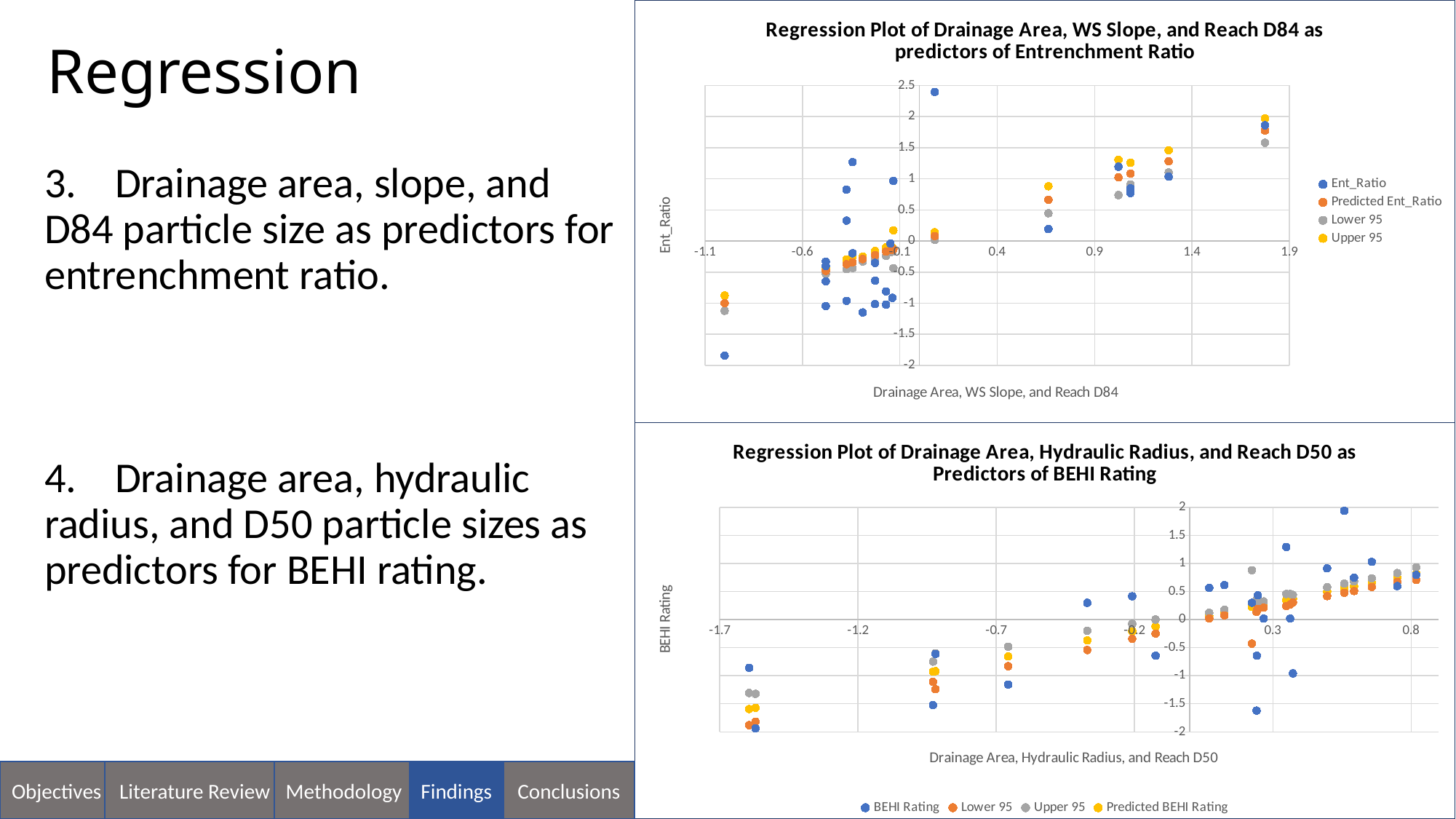
In the top chart (Entrenchment Ratio), do the Predicted Ent_Ratio values generally rise or fall as the x-axis value increases? rise How many series does the legend of the bottom chart (BEHI Rating) list? 4 In the top chart (Entrenchment Ratio), is the lowest Ent_Ratio point greater or less than -1.5? less What is the x-axis title of the bottom chart (BEHI Rating)? Drainage Area, Hydraulic Radius, and Reach D50 In the bottom chart (BEHI Rating), is the lowest BEHI Rating point greater or less than -1.5? less In the top chart (Entrenchment Ratio), is the highest Ent_Ratio point greater or less than 2? greater How many series does the legend of the top chart (Entrenchment Ratio) list? 4 In the top chart (Entrenchment Ratio), which series is shown in blue? Ent_Ratio In the bottom chart (BEHI Rating), do the Predicted BEHI Rating values generally rise or fall as the x-axis value increases? rise What kind of chart is the bottom chart, titled 'Regression Plot of Drainage Area, Hydraulic Radius, and Reach D50 as Predictors of BEHI Rating'? scatter chart What kind of chart is the top chart, titled 'Regression Plot of Drainage Area, WS Slope, and Reach D84 as predictors of Entrenchment Ratio'? scatter chart